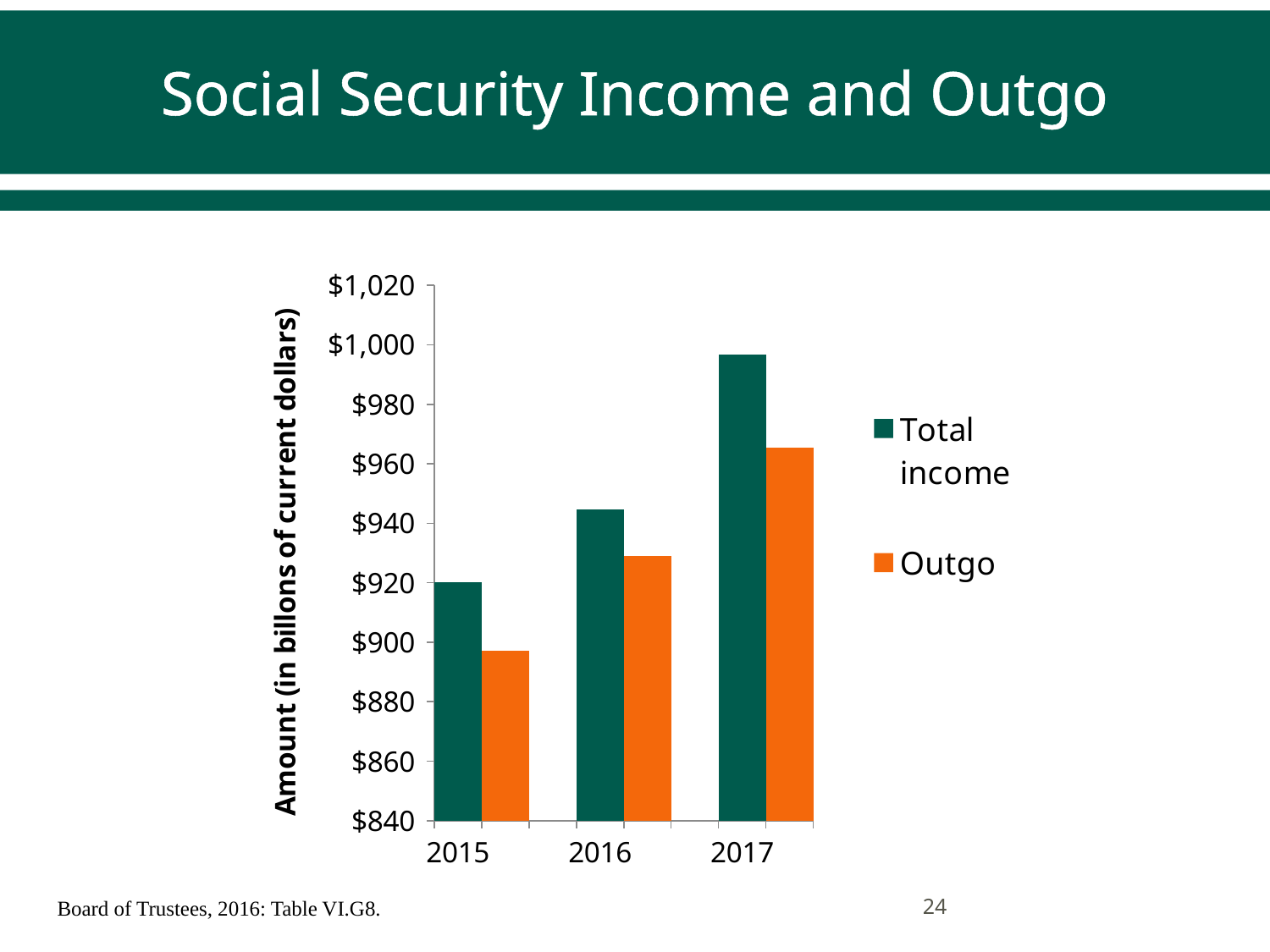
In 2016, which is larger: Total income or Outgo? Total income In which year is Outgo lowest? 2015 Does Total income rise or fall from 2015 to 2017? rise What colour are the Outgo bars? orange Is the value for Outgo in 2016 greater or less than $920? greater How many years are shown on the x axis? 3 Is the value for Outgo in 2015 greater or less than $900? less How many series does the legend list? 2 In which year is Total income highest? 2017 Is the value for Total income in 2017 greater or less than $980? greater What is the title of the vertical axis? Amount (in billons of current dollars) What kind of chart is shown on the slide? bar chart